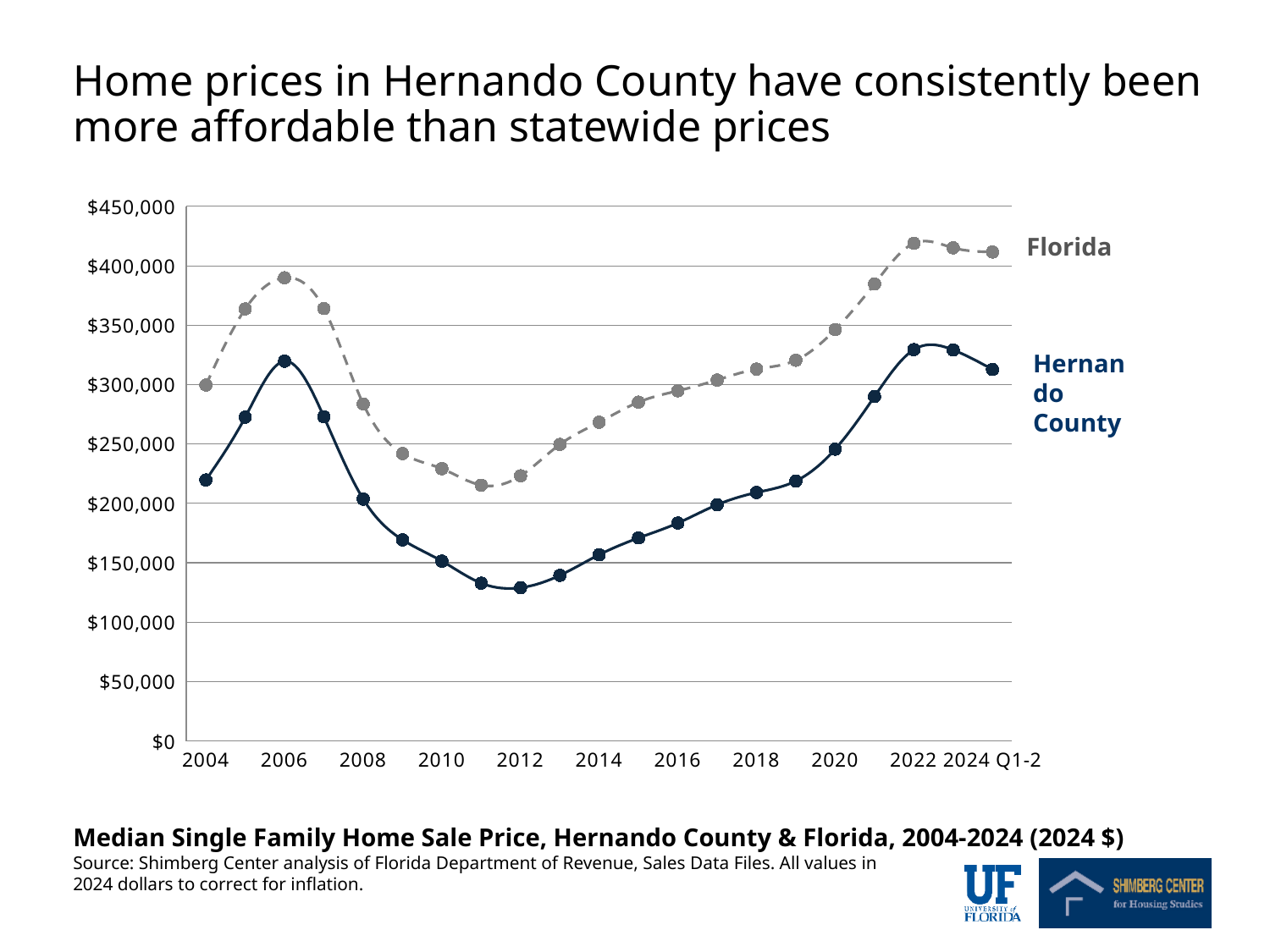
How many series does the chart show? 2 Is the value for Hernando County in 2012 greater or less than $150,000? less Is the value for Hernando County in 2006 greater or less than $300,000? greater Does the Hernando County series rise or fall between 2012 and 2022? rise In which year does the Florida series reach its highest value? 2022 In 2010, which series has the higher value, Florida or Hernando County? Florida What is the title of the chart? Median Single Family Home Sale Price, Hernando County & Florida, 2004-2024 (2024 $) What kind of chart is shown on the slide? line chart Is the value for Florida in 2022 greater or less than $400,000? greater In which year does the Florida series reach its lowest value? 2011 Which series is drawn with a dashed gray line? Florida